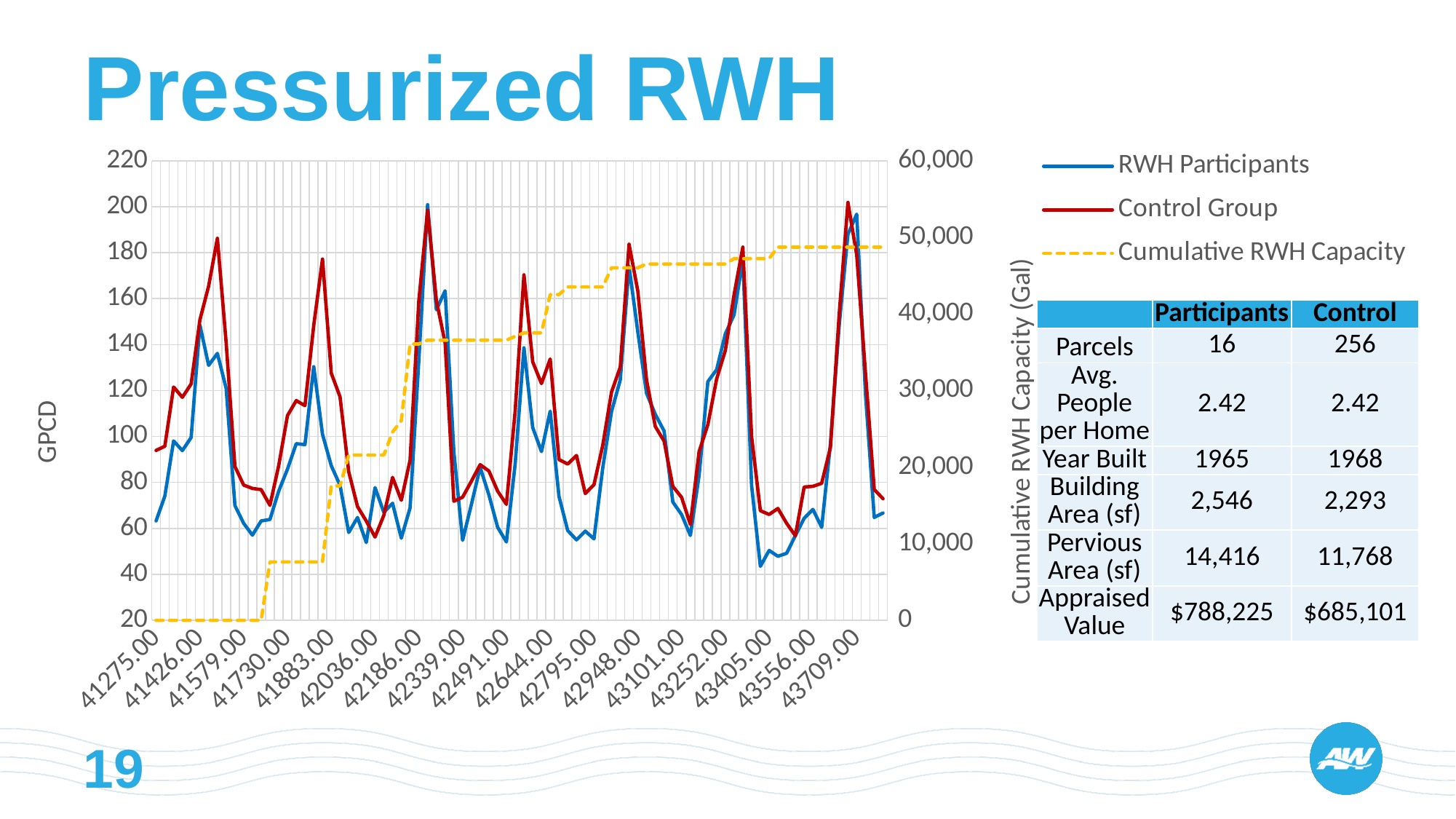
At 41275.00, which series has the higher value, RWH Participants or Control Group? Control Group Is the Cumulative RWH Capacity value at 43709.00 greater or less than 40,000? greater Is the RWH Participants value at 41275.00 greater or less than 80? less Is the Cumulative RWH Capacity value at 41730.00 greater or less than 20,000? less How many series does the chart's legend list? 3 Does the Cumulative RWH Capacity series rise or fall along the x axis? rise Which series in the chart is drawn with a dashed line? Cumulative RWH Capacity How many labels are shown along the chart's x axis? 17 What kind of chart is shown on the slide? line chart What is the title of the chart's left vertical axis? GPCD